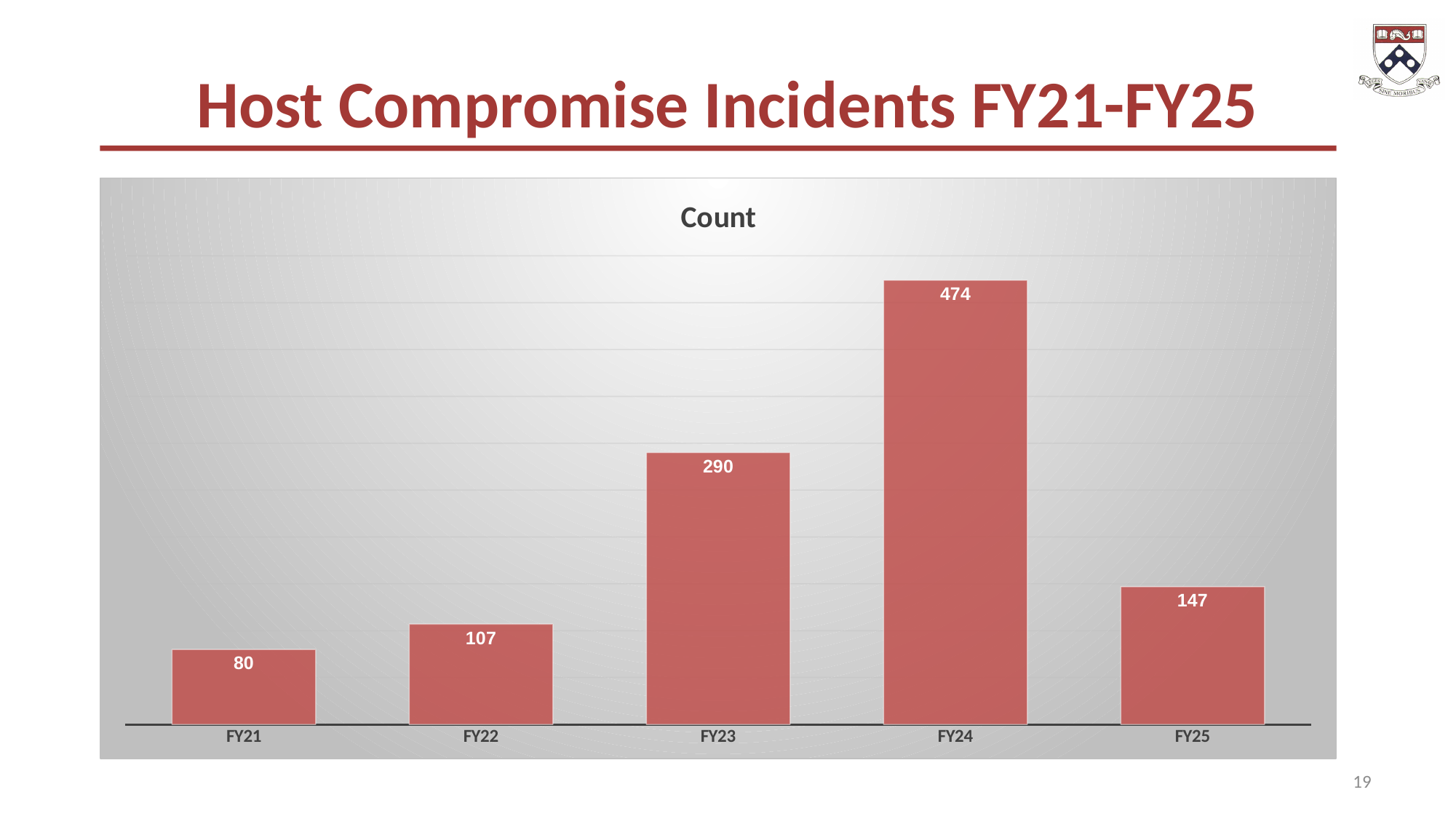
What is the count for FY25? 147 What is the difference between the counts for FY22 and FY21? 27 What is the count for FY21? 80 What kind of chart is shown on the slide? Bar chart What is the count for FY23? 290 Does the count rise or fall from FY24 to FY25? Fall Which fiscal year has the highest count? FY24 Which is larger, the count for FY25 or the count for FY22? FY25 Which fiscal year has the lowest count? FY21 What is the difference between the counts for FY24 and FY23? 184 What is the title shown above the chart? Count How many fiscal years are shown on the chart? 5